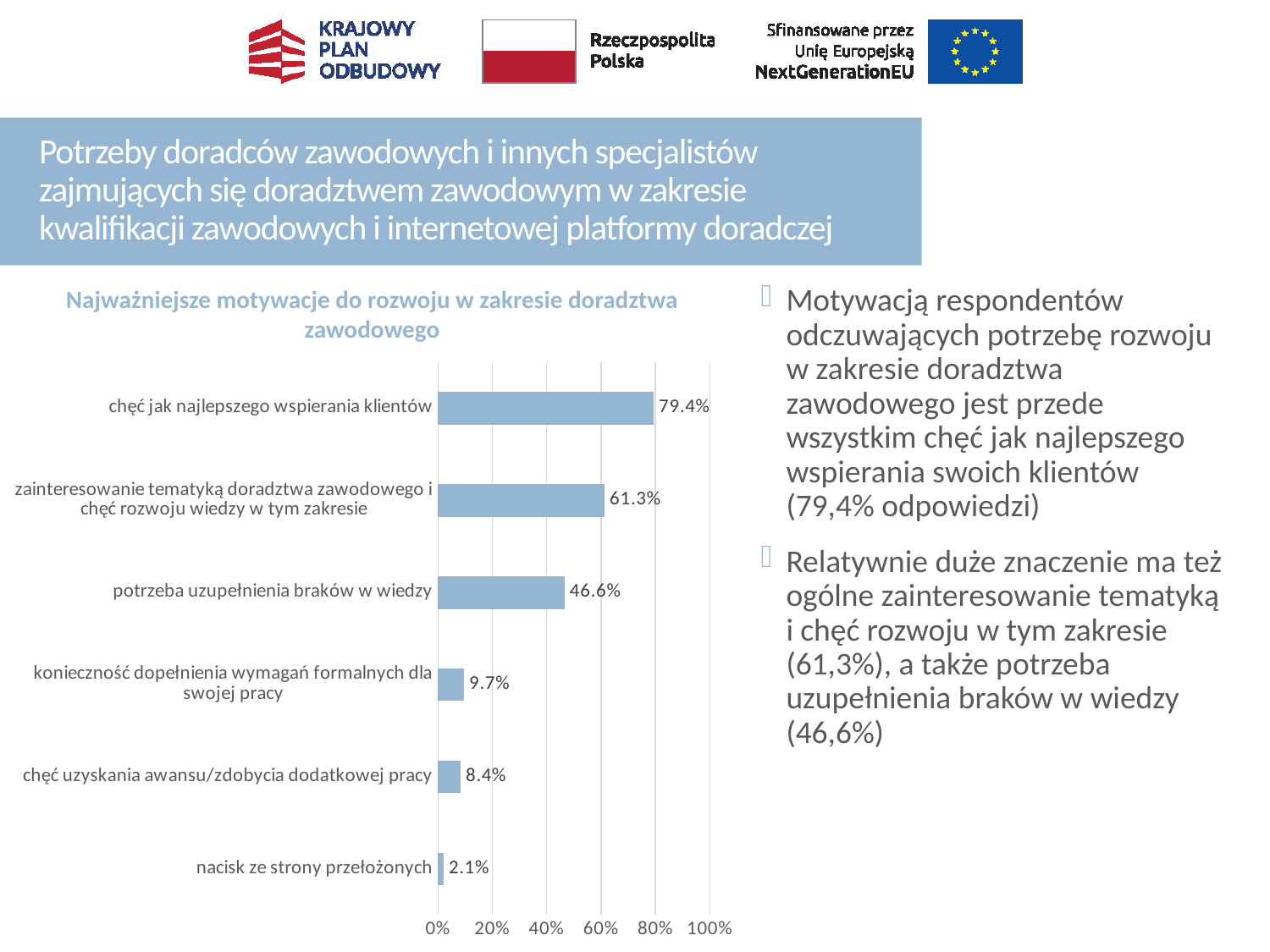
Which is larger: the value for "konieczność dopełnienia wymagań formalnych dla swojej pracy" or for "chęć uzyskania awansu/zdobycia dodatkowej pracy"? konieczność dopełnienia wymagań formalnych dla swojej pracy Which category has the highest value? chęć jak najlepszego wspierania klientów What kind of chart is shown on the slide? bar chart What is the value for "chęć jak najlepszego wspierania klientów"? 79.4% How many categories are shown in the chart? 6 Is the value for "potrzeba uzupełnienia braków w wiedzy" greater or less than 40%? greater What is the title of the chart? Najważniejsze motywacje do rozwoju w zakresie doradztwa zawodowego What is the difference between the values for "chęć jak najlepszego wspierania klientów" and "zainteresowanie tematyką doradztwa zawodowego i chęć rozwoju wiedzy w tym zakresie"? 18.1 percentage points Which category has the lowest value? nacisk ze strony przełożonych What is the value for "chęć uzyskania awansu/zdobycia dodatkowej pracy"? 8.4% What is the value for "nacisk ze strony przełożonych"? 2.1% What is the value for "potrzeba uzupełnienia braków w wiedzy"? 46.6%